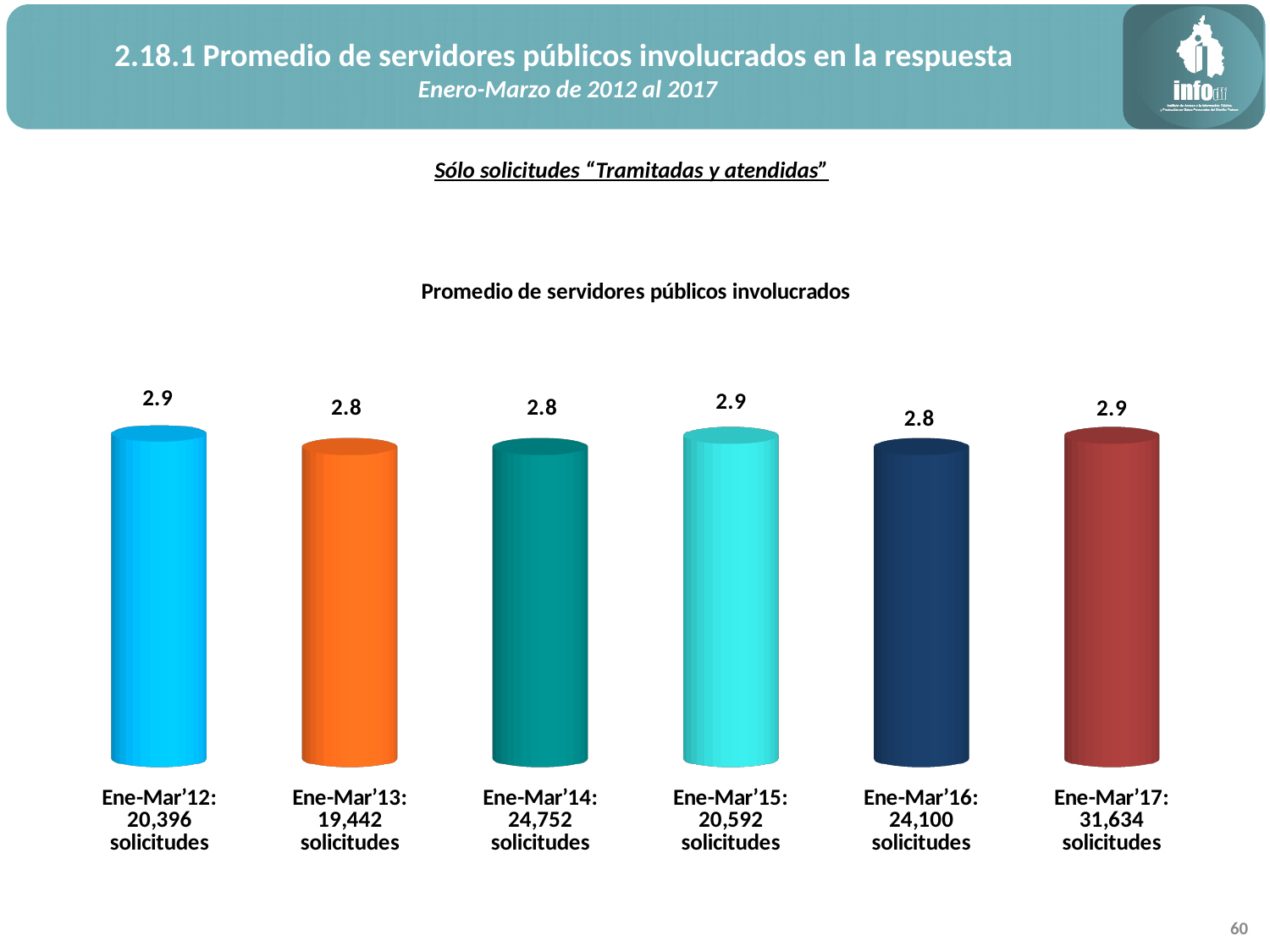
What is the difference between the value for Ene-Mar'12 and the value for Ene-Mar'13? 0.1 What is the value shown for Ene-Mar'13? 2.8 How many solicitudes are listed in the label for Ene-Mar'17? 31,634 solicitudes What is the average number of public servants involved for Ene-Mar'12? 2.9 How many periods (bars) are shown in the chart? 6 What is the value shown for Ene-Mar'16? 2.8 What kind of chart is shown on the slide? Bar chart Which is larger, the value for Ene-Mar'15 or the value for Ene-Mar'16? Ene-Mar'15 What colour is the bar for Ene-Mar'13? Orange How many solicitudes are listed in the label for Ene-Mar'14? 24,752 solicitudes What is the title of the chart? Promedio de servidores públicos involucrados What is the value shown for Ene-Mar'17? 2.9